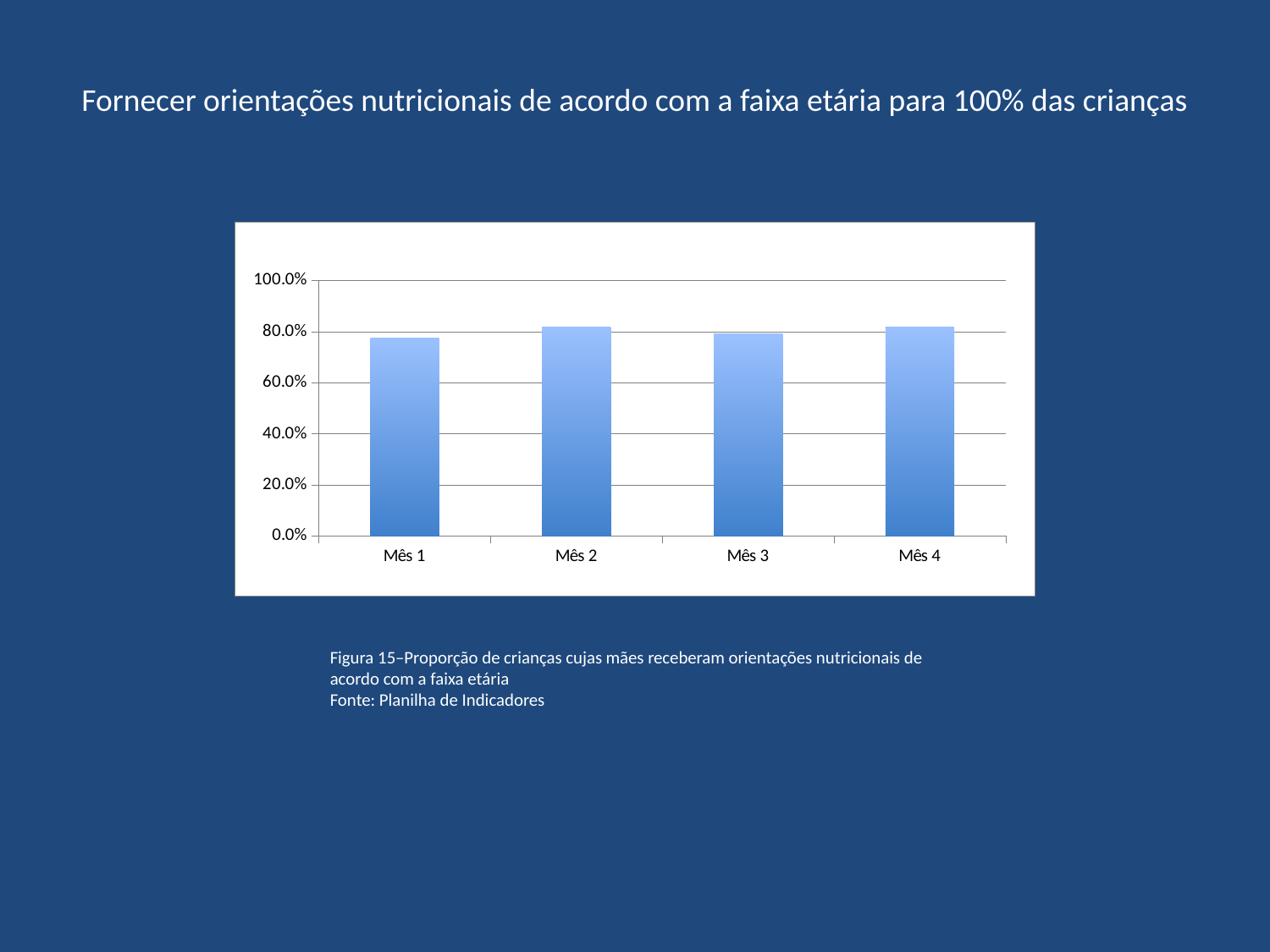
What source is cited for the chart data? Planilha de Indicadores Is the value for Mês 1 greater or less than 80.0%? less Which is larger, the value for Mês 1 or the value for Mês 2? Mês 2 What kind of chart is shown on the slide? bar chart Is the value for Mês 3 greater or less than 100.0%? less Is the value for Mês 1 greater or less than 60.0%? greater How many categories (months) are plotted on the chart? 4 What is the figure number given in the caption below the chart? Figura 15 Does the value rise or fall from Mês 1 to Mês 2? rise Which month has the lowest value on the chart? Mês 1 Which is larger, the value for Mês 4 or the value for Mês 1? Mês 4